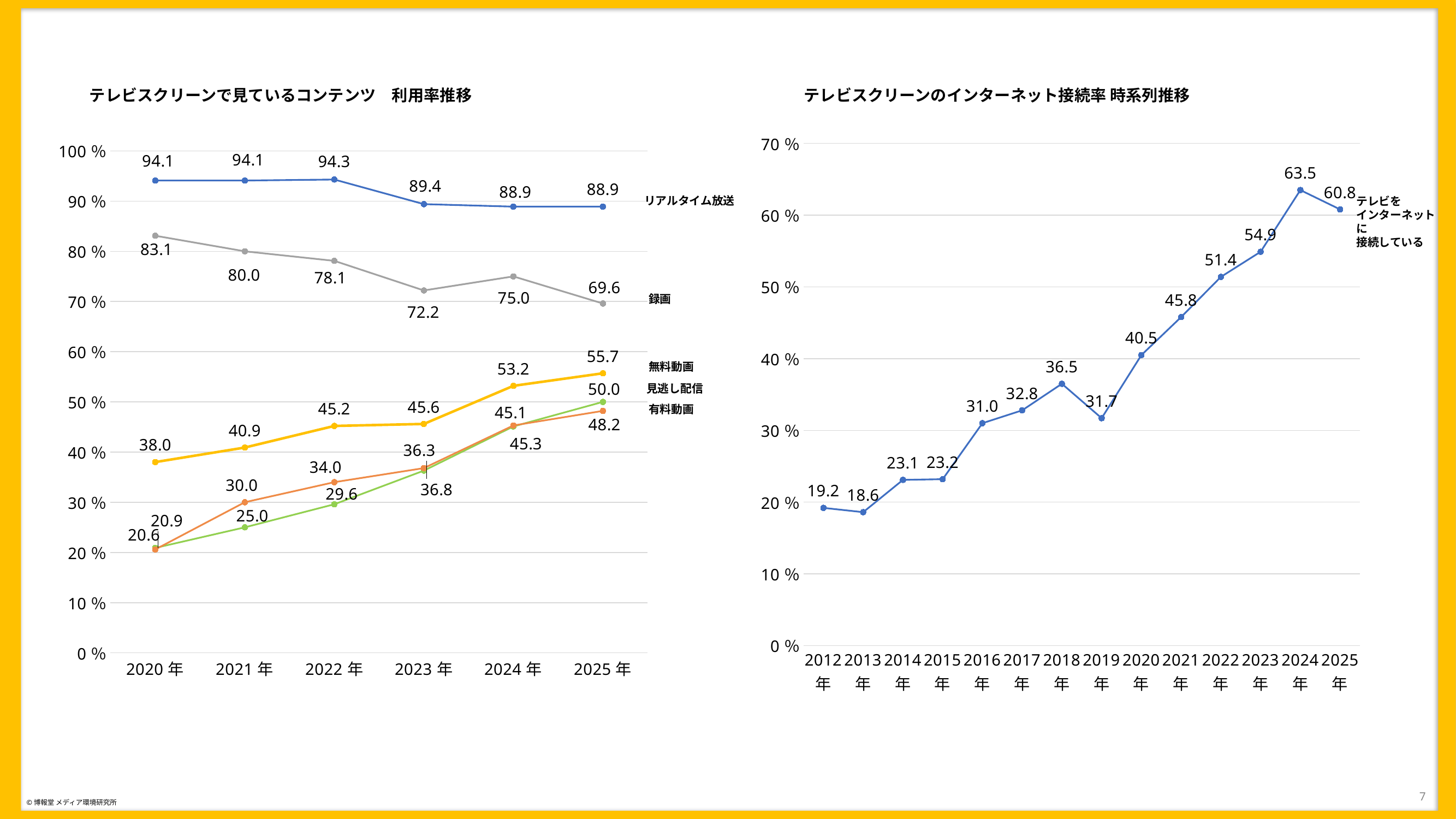
In the chart titled テレビスクリーンで見ているコンテンツ 利用率推移, how many series are plotted? 5 In the chart titled テレビスクリーンのインターネット接続率 時系列推移, which year has the lowest value? 2013年 What kind of chart is the one titled テレビスクリーンで見ているコンテンツ 利用率推移? Line chart In the chart titled テレビスクリーンのインターネット接続率 時系列推移, how many years are plotted? 14 In the chart titled テレビスクリーンで見ているコンテンツ 利用率推移, which is larger in 2025年: 無料動画 or 有料動画? 無料動画 In the chart titled テレビスクリーンで見ているコンテンツ 利用率推移, does the 無料動画 series rise or fall from 2020年 to 2025年? Rises In the chart titled テレビスクリーンのインターネット接続率 時系列推移, what is the value for 2019年? 31.7 In the chart titled テレビスクリーンで見ているコンテンツ 利用率推移, what is the difference between the リアルタイム放送 value in 2020年 and in 2025年? 5.2 In the chart titled テレビスクリーンで見ているコンテンツ 利用率推移, what is the value for 録画 in 2023年? 72.2 In the chart titled テレビスクリーンのインターネット接続率 時系列推移, what is the value for 2024年? 63.5 In the chart titled テレビスクリーンのインターネット接続率 時系列推移, what is the difference between the 2025年 value and the 2012年 value? 41.6 In the chart titled テレビスクリーンのインターネット接続率 時系列推移, which year has the highest value? 2024年